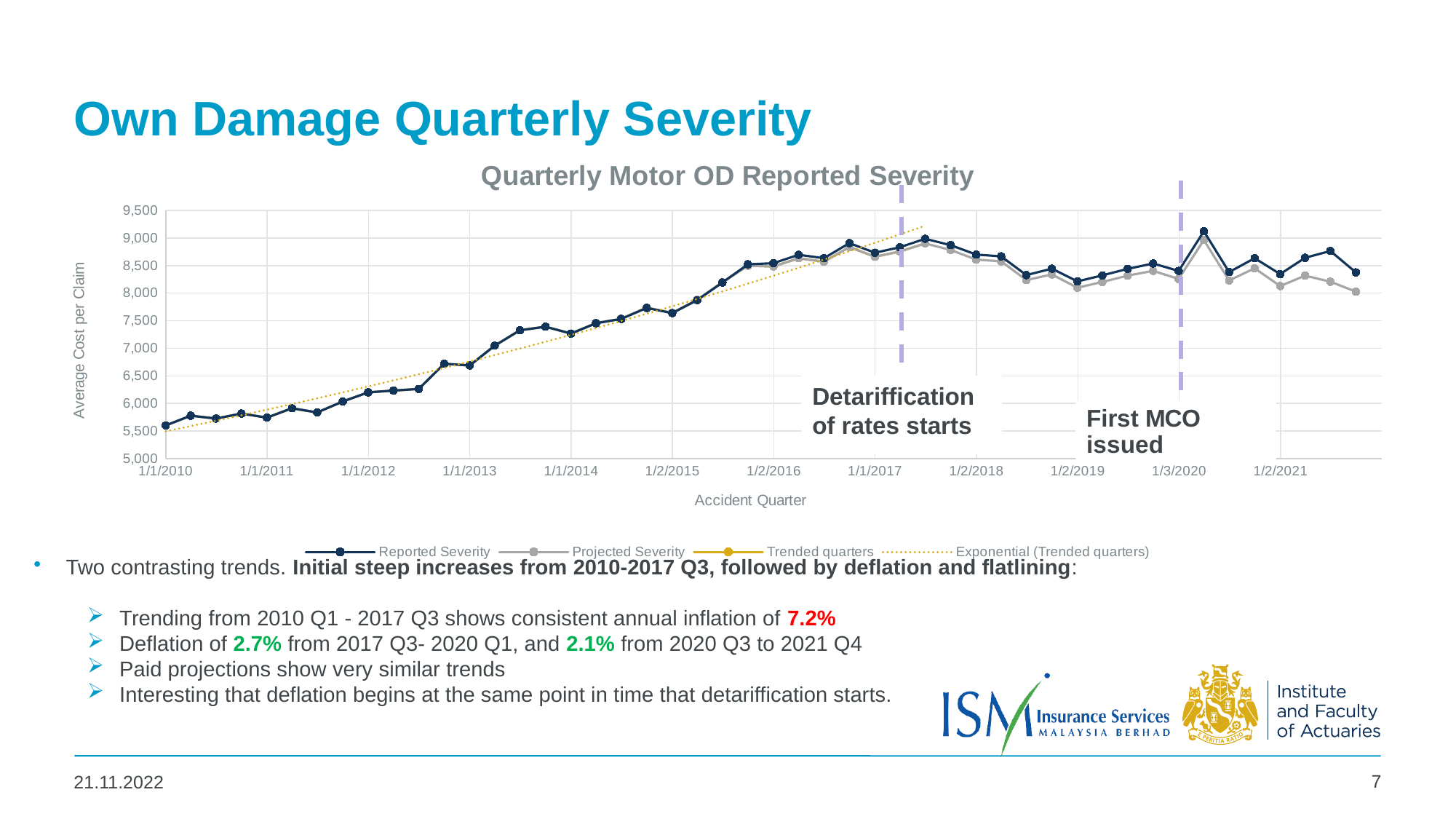
Is the Reported Severity value at 1/1/2013 greater or less than 6,500? greater What is the title of the chart? Quarterly Motor OD Reported Severity What type of chart is shown on the slide? Line chart Does the Reported Severity line generally rise or fall between 1/1/2010 and 1/1/2017? rise Is the Reported Severity value at 1/2/2019 greater or less than 8,500? less At 1/2/2021, which series is higher, Reported Severity or Projected Severity? Reported Severity Is the Reported Severity value at 1/1/2010 greater or less than 6,000? less Which is larger, the Reported Severity value at 1/1/2017 or at 1/1/2010? 1/1/2017 How many series does the chart legend list? 4 How many date labels are shown on the x axis of the chart? 12 What is the label of the vertical axis of the chart? Average Cost per Claim